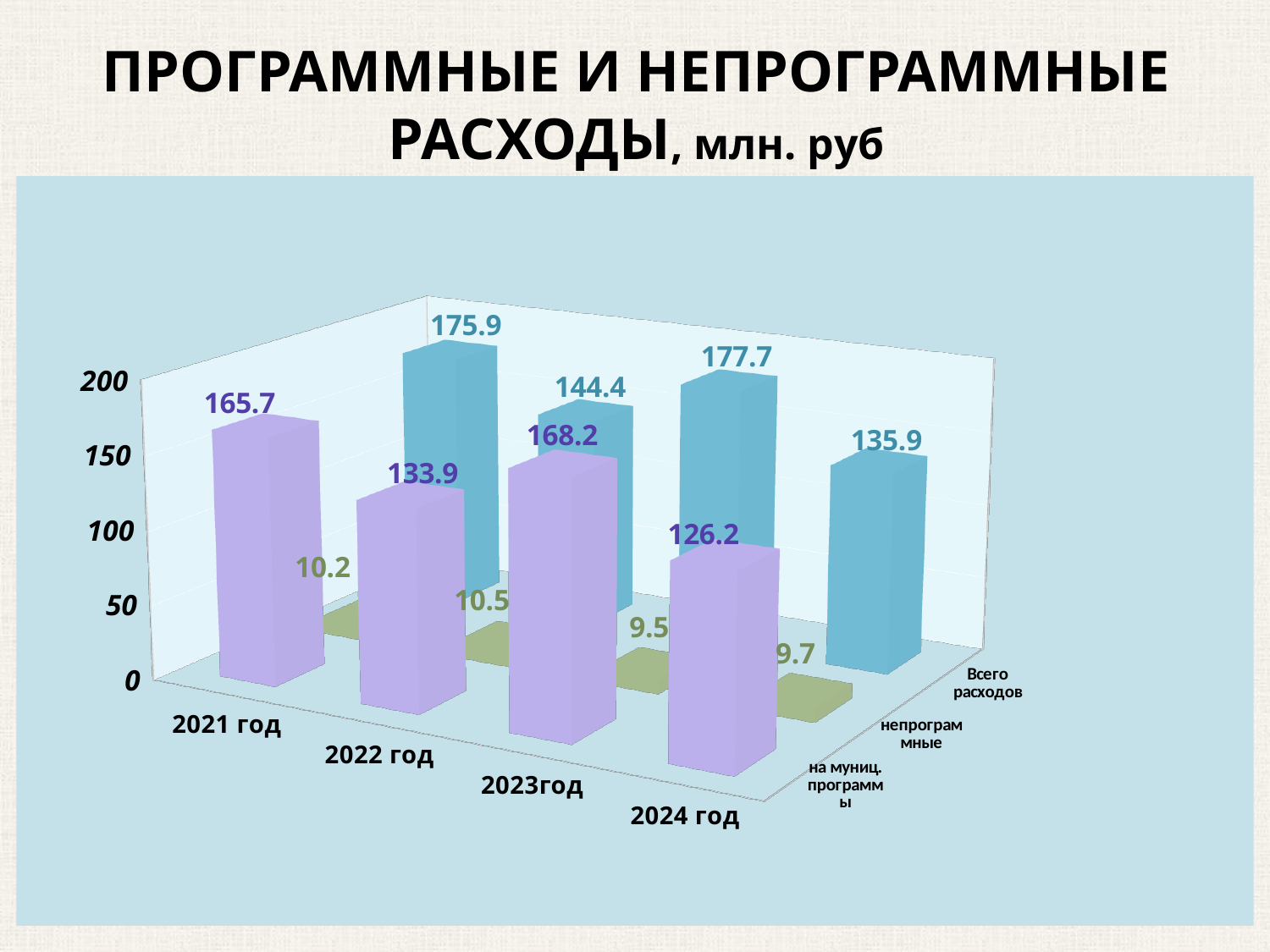
What is the value for 'Всего расходов' in 2023 год? 177.7 What is the value for 'на муниц. программы' in 2024 год? 126.2 How many data series does the chart show? 3 Which is larger: 'непрограммные' in 2021 год or in 2023 год? 2021 год What kind of chart is shown on the slide? bar chart Which year has the lowest value for 'на муниц. программы'? 2024 год What unit is given in the chart title? млн. руб What is the difference between 'Всего расходов' in 2021 год and 2022 год? 31.5 What is the value for 'непрограммные' in 2022 год? 10.5 Which year has the highest value for 'Всего расходов'? 2023 год How many years are shown on the x axis? 4 What is the value for 'на муниц. программы' in 2021 год? 165.7